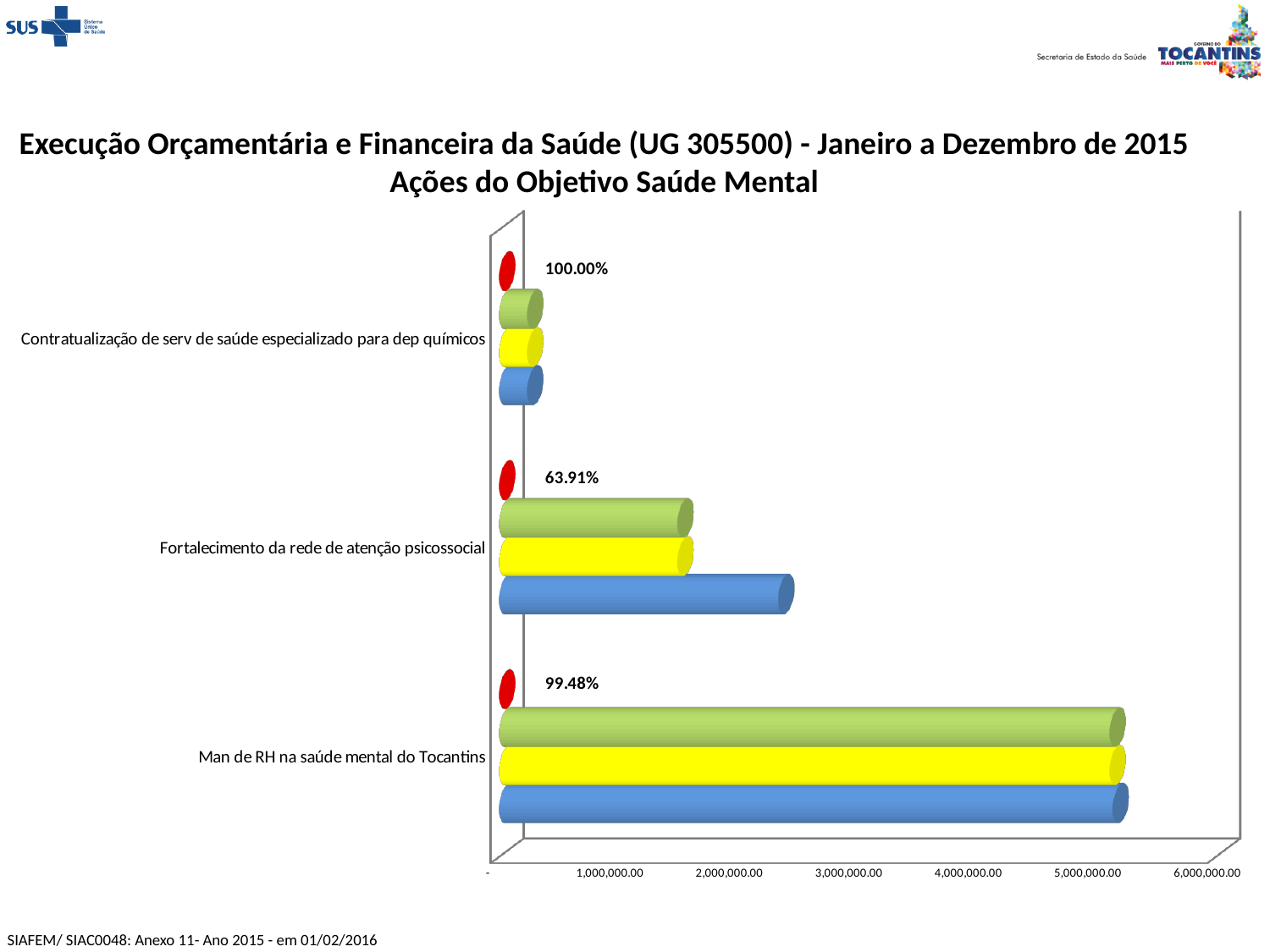
Which category has the lowest percentage label? Fortalecimento da rede de atenção psicossocial What percentage is shown for 'Fortalecimento da rede de atenção psicossocial'? 63.91% What percentage is shown for 'Contratualização de serv de saúde especializado para dep químicos'? 100.00% How many categories are shown on the chart? 3 Is the blue bar for 'Fortalecimento da rede de atenção psicossocial' greater or less than 3,000,000.00? less Which category has the shortest bars on the chart? Contratualização de serv de saúde especializado para dep químicos What percentage is shown for 'Man de RH na saúde mental do Tocantins'? 99.48% Is the blue bar for 'Man de RH na saúde mental do Tocantins' greater or less than 5,000,000.00? greater Which category has the longest bars on the chart? Man de RH na saúde mental do Tocantins What kind of chart is shown on the slide? Bar chart Is the green bar for 'Fortalecimento da rede de atenção psicossocial' greater or less than 1,000,000.00? greater Which category has the highest percentage label? Contratualização de serv de saúde especializado para dep químicos